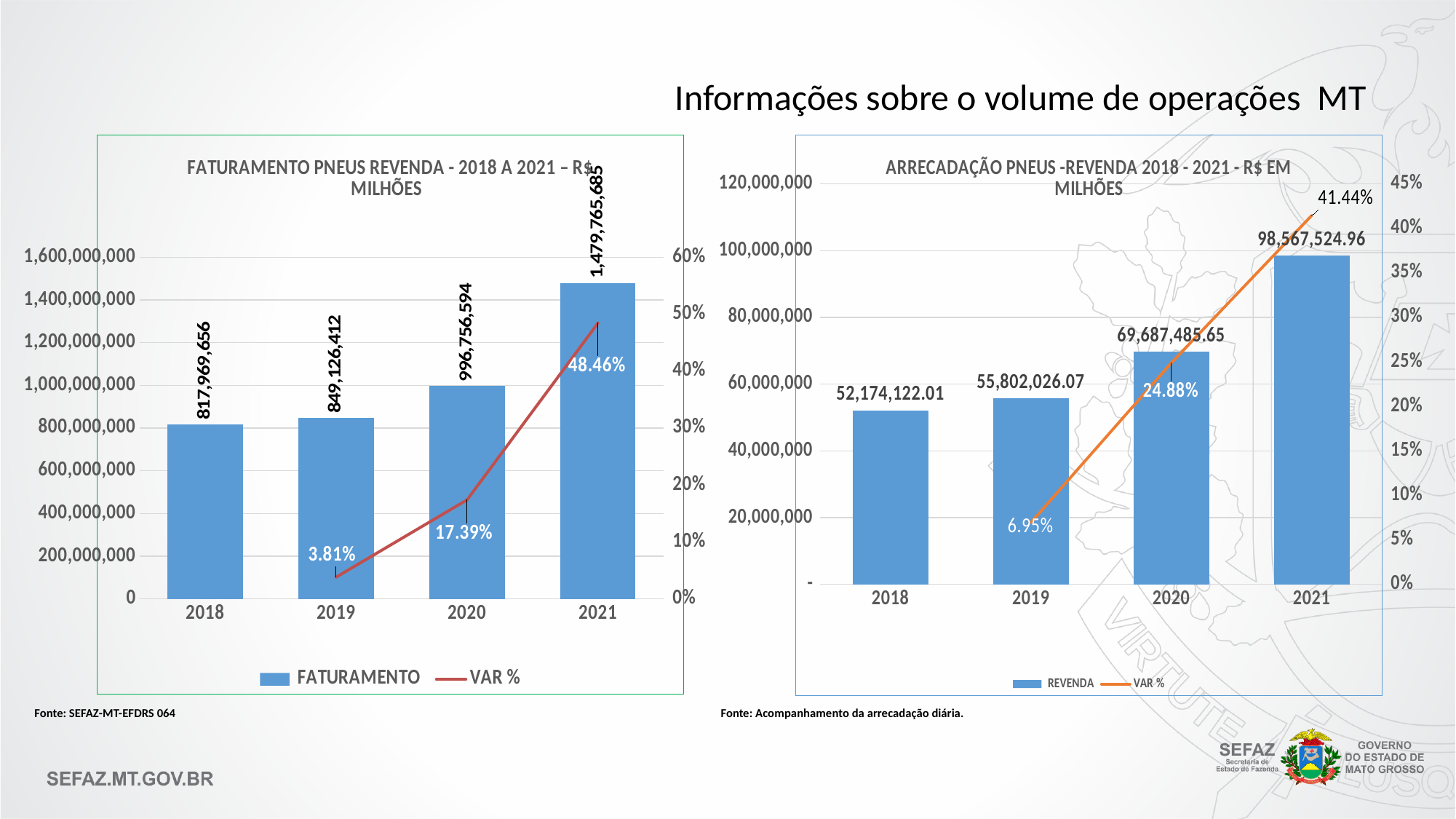
In the ARRECADAÇÃO PNEUS -REVENDA chart, which year has the highest REVENDA? 2021 In the FATURAMENTO PNEUS REVENDA chart, how many series does the legend list? 2 In the ARRECADAÇÃO PNEUS -REVENDA chart, what is the VAR % value for 2020? 24.88% In the FATURAMENTO PNEUS REVENDA chart, which year has the lowest FATURAMENTO? 2018 In the FATURAMENTO PNEUS REVENDA chart, what is the difference between the FATURAMENTO for 2019 and 2018? 31,156,756 In the ARRECADAÇÃO PNEUS -REVENDA chart, is the REVENDA for 2021 greater or less than 80,000,000? greater In the ARRECADAÇÃO PNEUS -REVENDA chart, how many years are shown on the x axis? 4 In the ARRECADAÇÃO PNEUS -REVENDA chart, what is the REVENDA value for 2019? 55,802,026.07 What kind of chart is the ARRECADAÇÃO PNEUS -REVENDA chart? Combined bar and line chart In the FATURAMENTO PNEUS REVENDA chart, does the FATURAMENTO rise or fall from 2018 to 2021? rise In the FATURAMENTO PNEUS REVENDA chart, what is the VAR % value for 2021? 48.46% In the FATURAMENTO PNEUS REVENDA chart, what is the FATURAMENTO value for 2020? 996,756,594